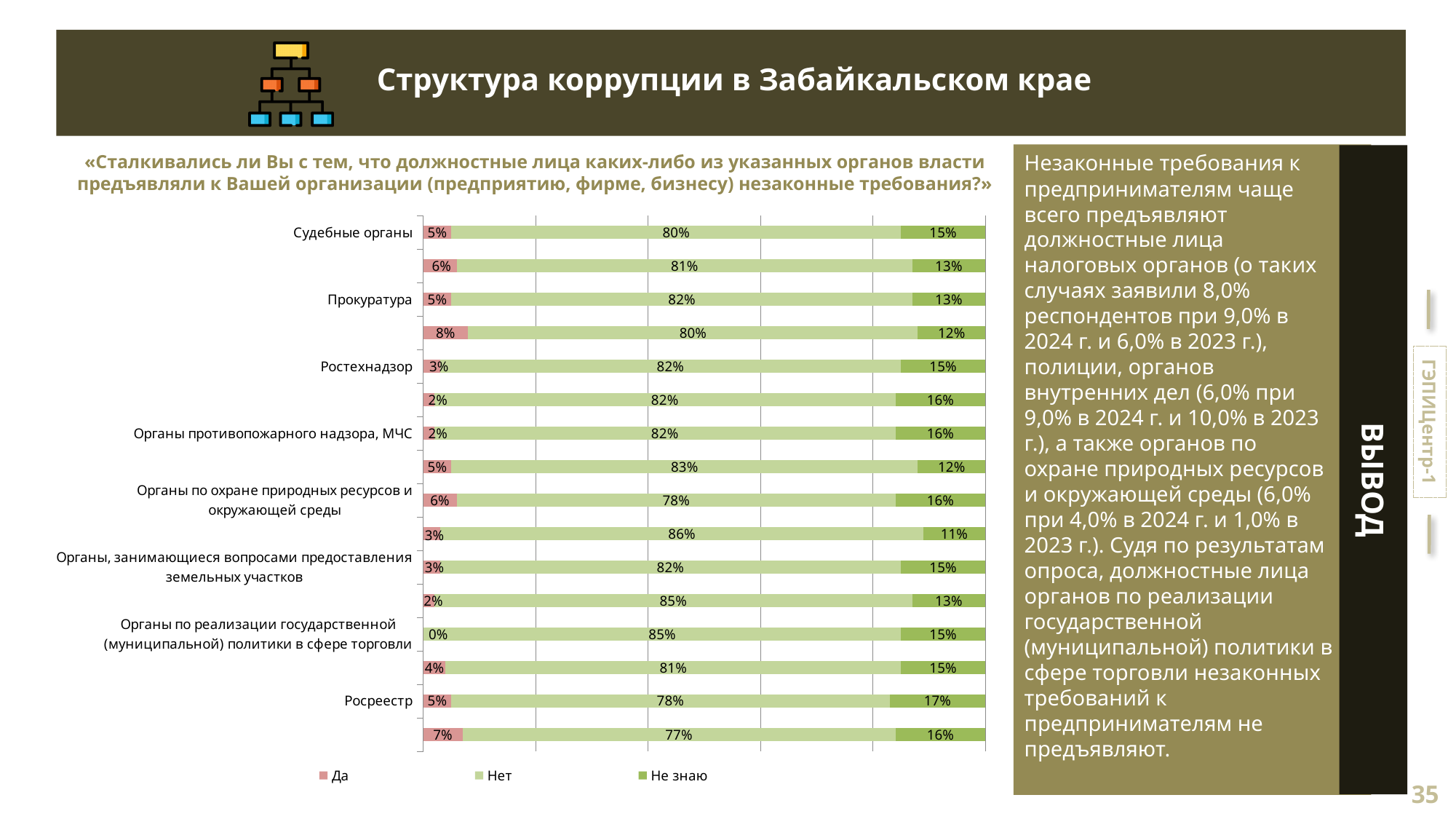
Which has the larger "Не знаю" value: Росреестр or Прокуратура? Росреестр Among the labelled categories, which has the lowest "Да" value? Органы по реализации государственной (муниципальной) политики в сфере торговли What is the "Нет" value for Органы по охране природных ресурсов и окружающей среды? 78% How many series does the legend list? 3 What is the "Не знаю" value for Росреестр? 17% What is the difference between the "Нет" and "Да" values for Судебные органы? 75% What is the "Да" value for Судебные органы? 5% What is the total of the stacked bar for Ростехнадзор? 100% What is the "Да" value for Органы по реализации государственной (муниципальной) политики в сфере торговли? 0% What are the legend entries of the chart? Да, Нет, Не знаю What is the "Нет" value for Прокуратура? 82% What kind of chart is shown on the slide? Stacked horizontal bar chart